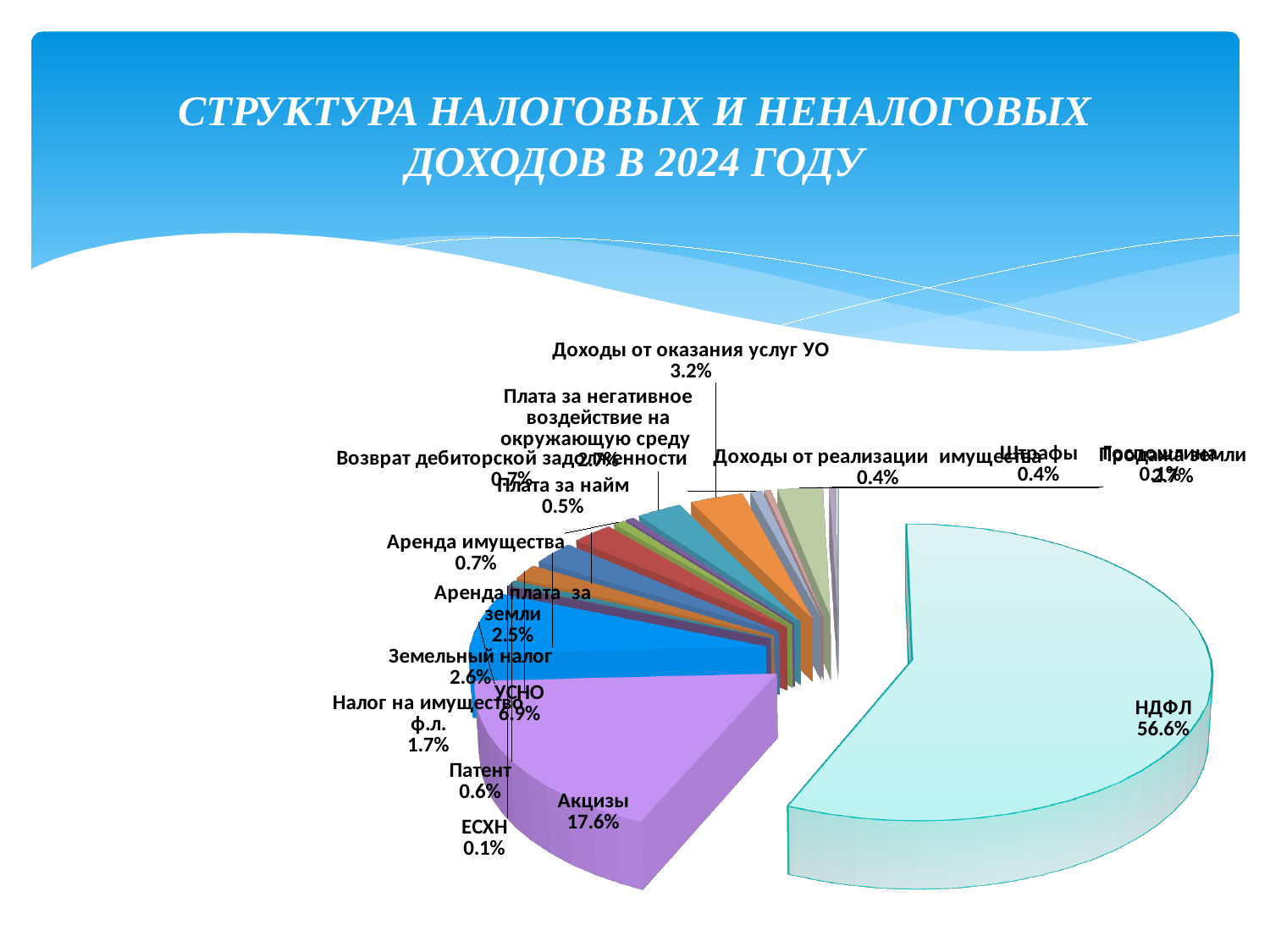
Which is larger, the share for УСНО or the share for Акцизы? Акцизы What is the value shown for Акцизы? 17.6% What kind of chart is shown on the slide? Pie chart What percentage is shown for УСНО? 6.9% What is the title of the slide? СТРУКТУРА НАЛОГОВЫХ И НЕНАЛОГОВЫХ ДОХОДОВ В 2024 ГОДУ What is the value shown for ЕСХН? 0.1% What is the value labelled for Доходы от оказания услуг УО? 3.2% What percentage is shown for Земельный налог? 2.6% Which category has the largest slice of the pie? НДФЛ What is the difference between the shares of НДФЛ and Акцизы? 39.0% What is the difference between the shares of Акцизы and УСНО? 10.7% What share of the pie does НДФЛ account for? 56.6%